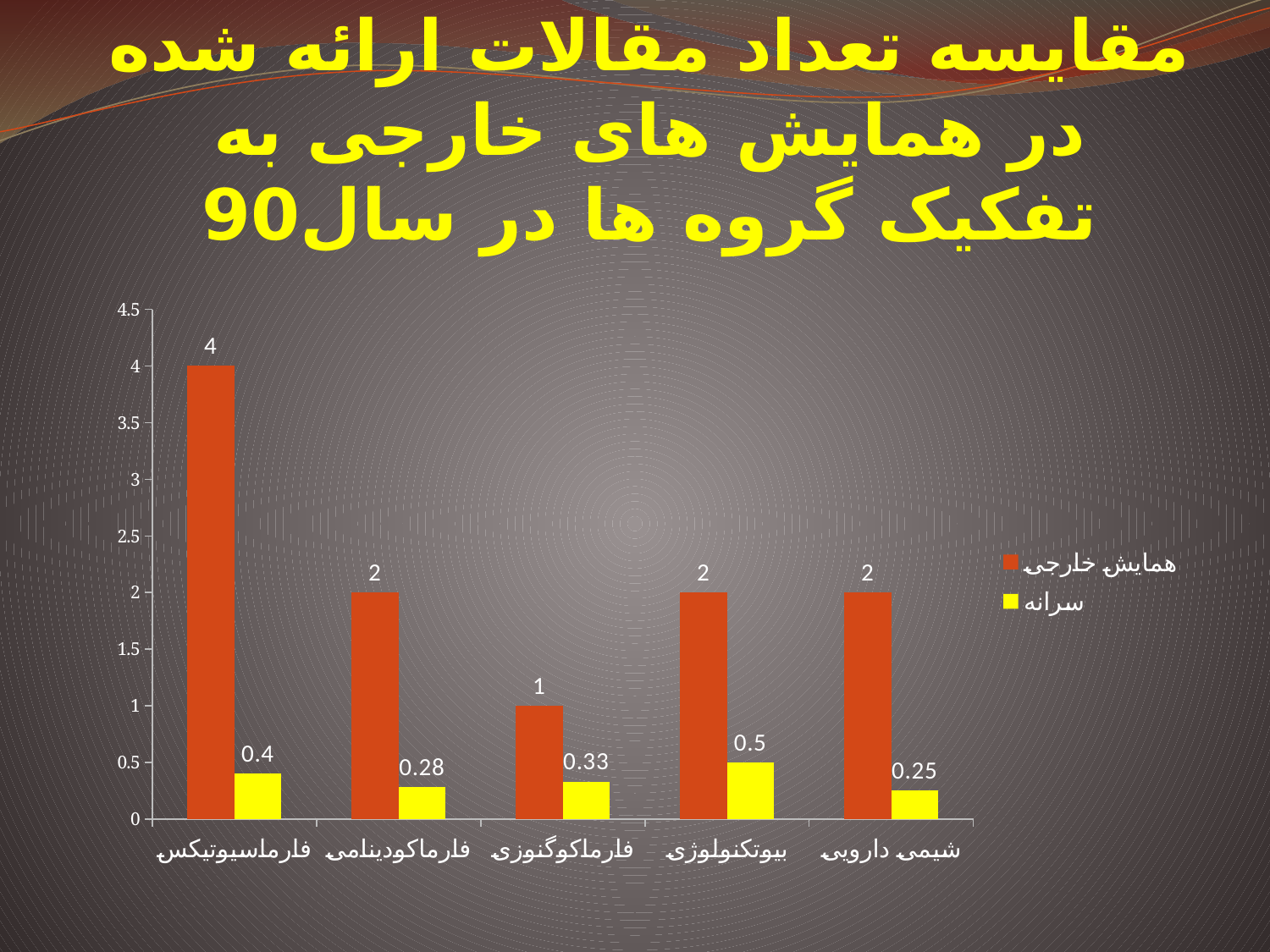
What is the value of سرانه for بیوتکنولوژی? 0.5 Which is larger, the سرانه value for فارماکوگنوزی or for شیمی دارویی? فارماکوگنوزی What type of chart is shown on the slide? bar chart What is the value of همایش خارجی for فارماکوگنوزی? 1 Which series is shown in yellow in the legend? سرانه Which category has the highest value for همایش خارجی? فارماسیوتیکس Which category has the lowest value for سرانه? شیمی دارویی What is the value of همایش خارجی for فارماسیوتیکس? 4 How many series does the legend list? 2 What is the value of سرانه for فارماکودینامی? 0.28 How many categories are shown on the x axis? 5 What is the difference between the همایش خارجی values for فارماسیوتیکس and فارماکودینامی? 2